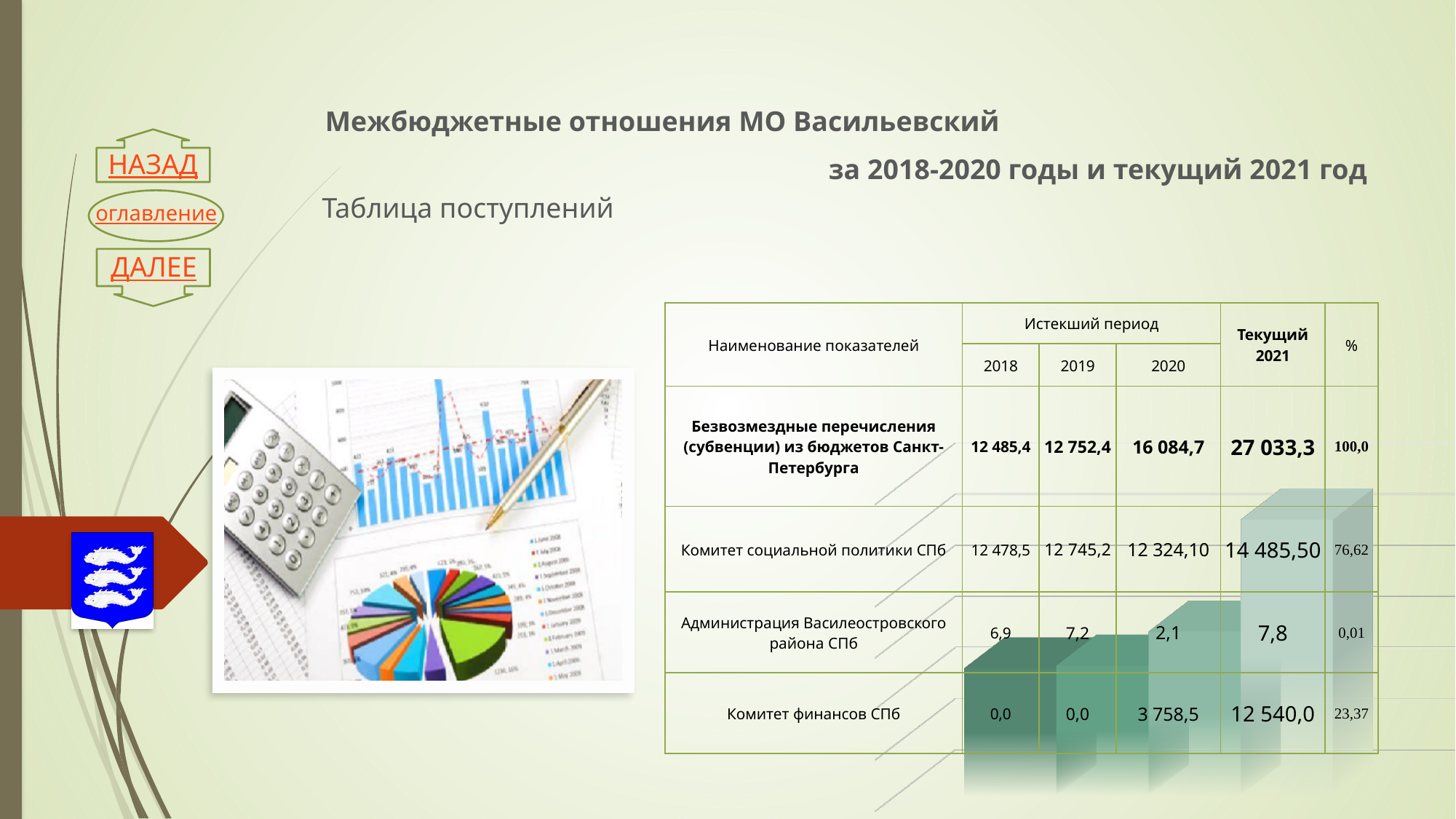
In the table, what percentage (%) is shown for 'Комитет финансов СПб'? 23,37 Which bar in the chart behind the table is the shortest? the leftmost bar What kind of chart is drawn behind the table on the right of the slide? bar chart How many bars does the chart behind the table show? 4 In the table, which is larger for 'Администрация Василеостровского района СПб': the 2019 value or the 2020 value? 2019 In the table, which year has the highest value for 'Безвозмездные перечисления (субвенции) из бюджетов Санкт-Петербурга'? 2021 What is the title of the table on the slide? Таблица поступлений In the table, what is the value of 'Комитет финансов СПб' for 2019? 0,0 In the table, what is the value of 'Безвозмездные перечисления (субвенции) из бюджетов Санкт-Петербурга' for 2020? 16 084,7 In the table, what is the value of 'Комитет социальной политики СПб' for Текущий 2021? 14 485,50 Do the bars in the chart behind the table rise or fall from left to right across the first four bars? rise In the table, what is the difference between the 2021 and 2020 values for 'Комитет финансов СПб'? 8 781,5